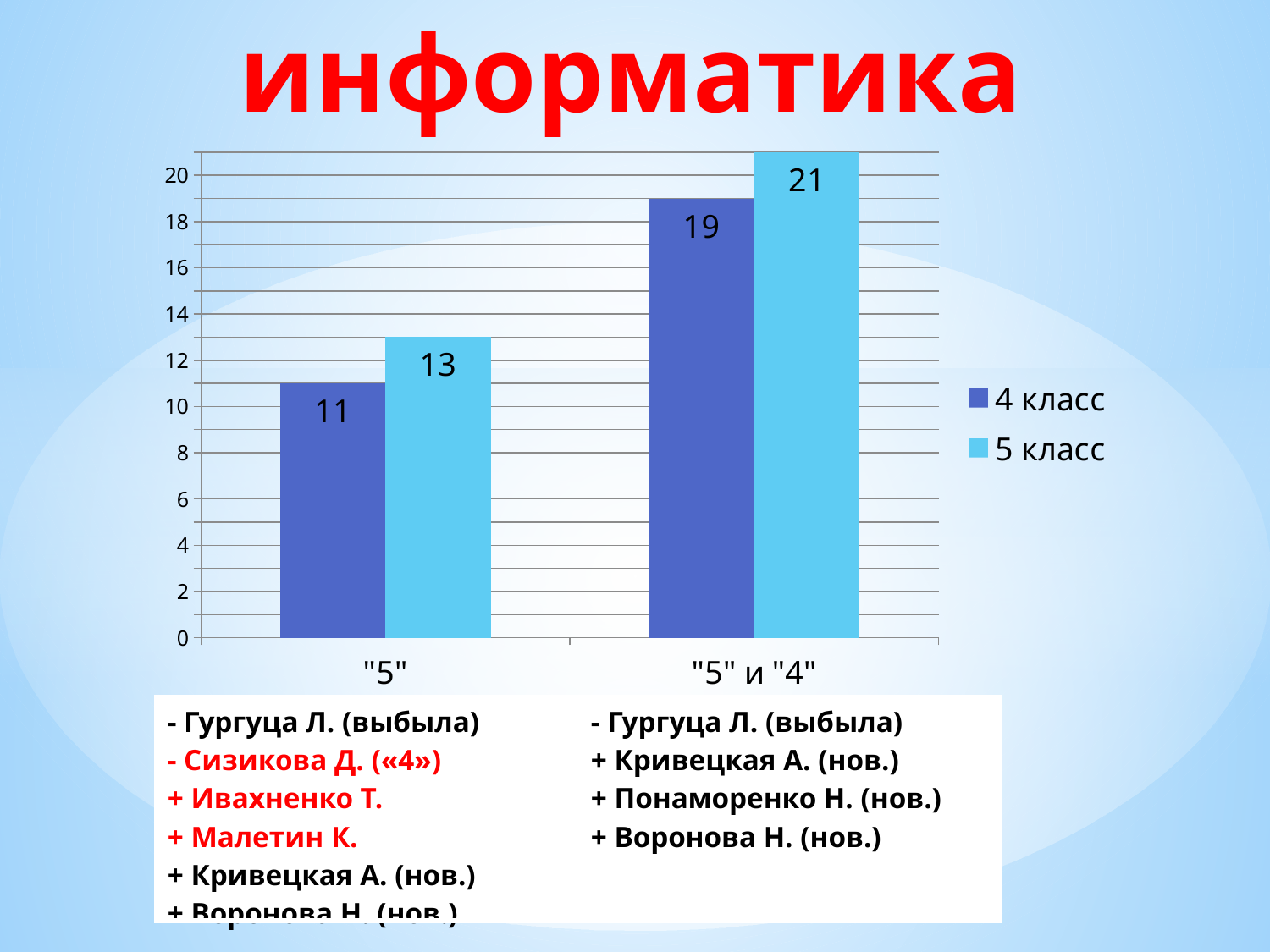
What is the difference between the "4 класс" values for "5" и "4" and "5"? 8 What is the difference between the "5 класс" and "4 класс" values in the "5" и "4" category? 2 Which series has the lowest value in the "5" category? 4 класс What is the value for "5 класс" in the "5" category? 13 Which is larger: the "5 класс" value for "5" or the "4 класс" value for "5" и "4"? 4 класс for "5" и "4" What kind of chart is shown on the slide? bar chart What is the value for "5 класс" in the "5" и "4" category? 21 What is the value for "4 класс" in the "5" category? 11 How many series does the legend list? 2 What is the value for "4 класс" in the "5" и "4" category? 19 How many categories are shown on the x axis? 2 Which series has the highest value in the "5" и "4" category? 5 класс